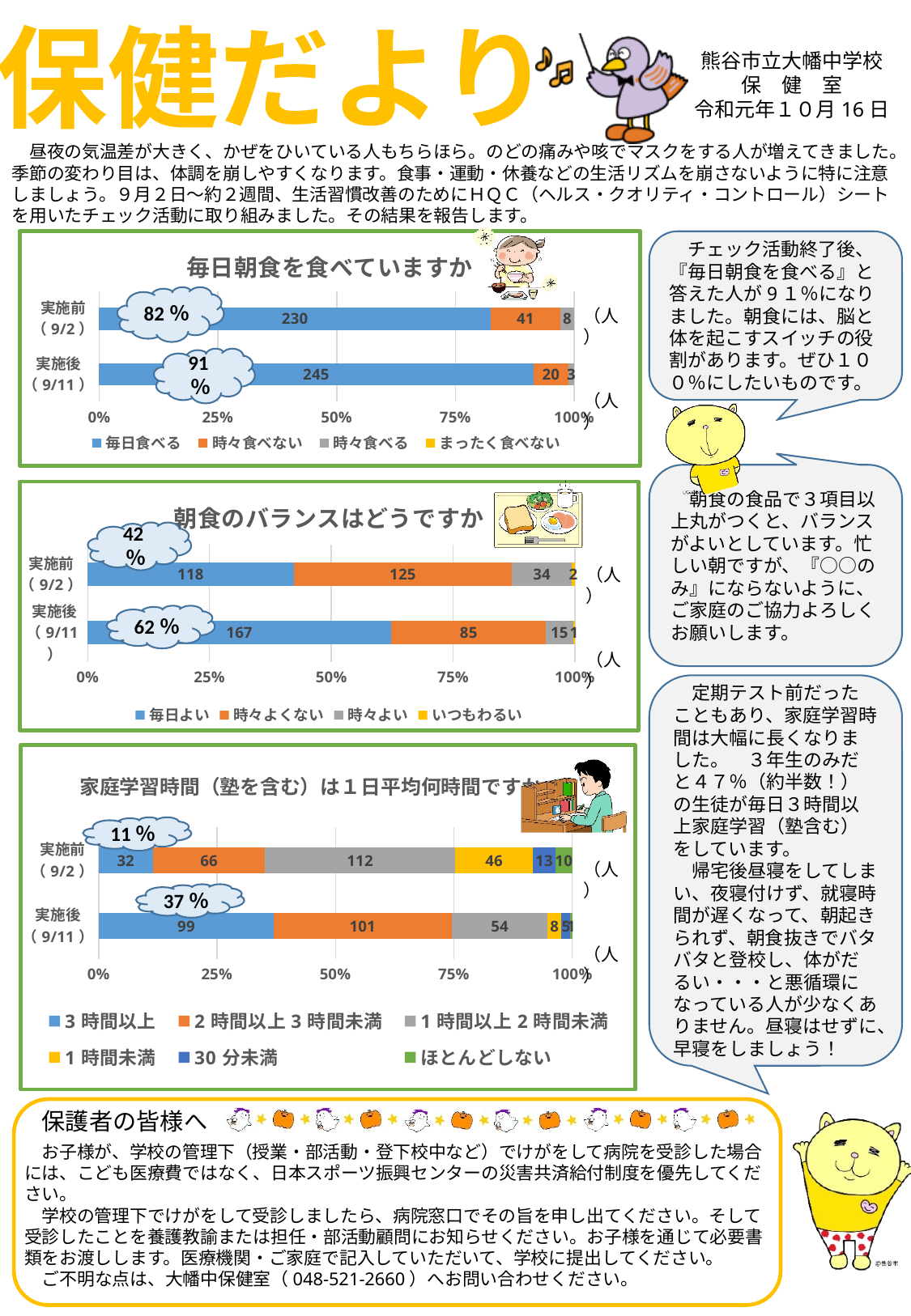
In the chart titled 「家庭学習時間（塾を含む）は１日平均何時間ですか」, how many students answered 3時間以上 in the 実施後（9/11） bar? 99 In the chart titled 「朝食のバランスはどうですか」, how many students answered 時々よくない in the 実施前（9/2） bar? 125 In the chart titled 「家庭学習時間（塾を含む）は１日平均何時間ですか」, how many students answered 1時間以上2時間未満 in the 実施前（9/2） bar? 112 In the chart titled 「毎日朝食を食べていますか」, how many students answered 毎日食べる in the 実施後（9/11） bar? 245 In the chart titled 「毎日朝食を食べていますか」, how many students answered 時々食べない in the 実施前（9/2） bar? 41 In the chart titled 「毎日朝食を食べていますか」, by how much did the 毎日食べる count increase from 実施前（9/2） to 実施後（9/11）? 15 In the chart titled 「家庭学習時間（塾を含む）は１日平均何時間ですか」, what is the difference between the 3時間以上 counts for 実施後（9/11） and 実施前（9/2）? 67 How many series does the legend list in the chart titled 「家庭学習時間（塾を含む）は１日平均何時間ですか」? 6 What kind of chart is the chart titled 「毎日朝食を食べていますか」? Stacked bar chart In the chart titled 「朝食のバランスはどうですか」, which is larger in the 実施後（9/11） bar: 毎日よい or 時々よくない? 毎日よい In the chart titled 「朝食のバランスはどうですか」, what percentage is shown in the cloud label on the 実施後（9/11） bar? 62％ In the chart titled 「朝食のバランスはどうですか」, what is the total number of students in the 実施後（9/11） bar? 268